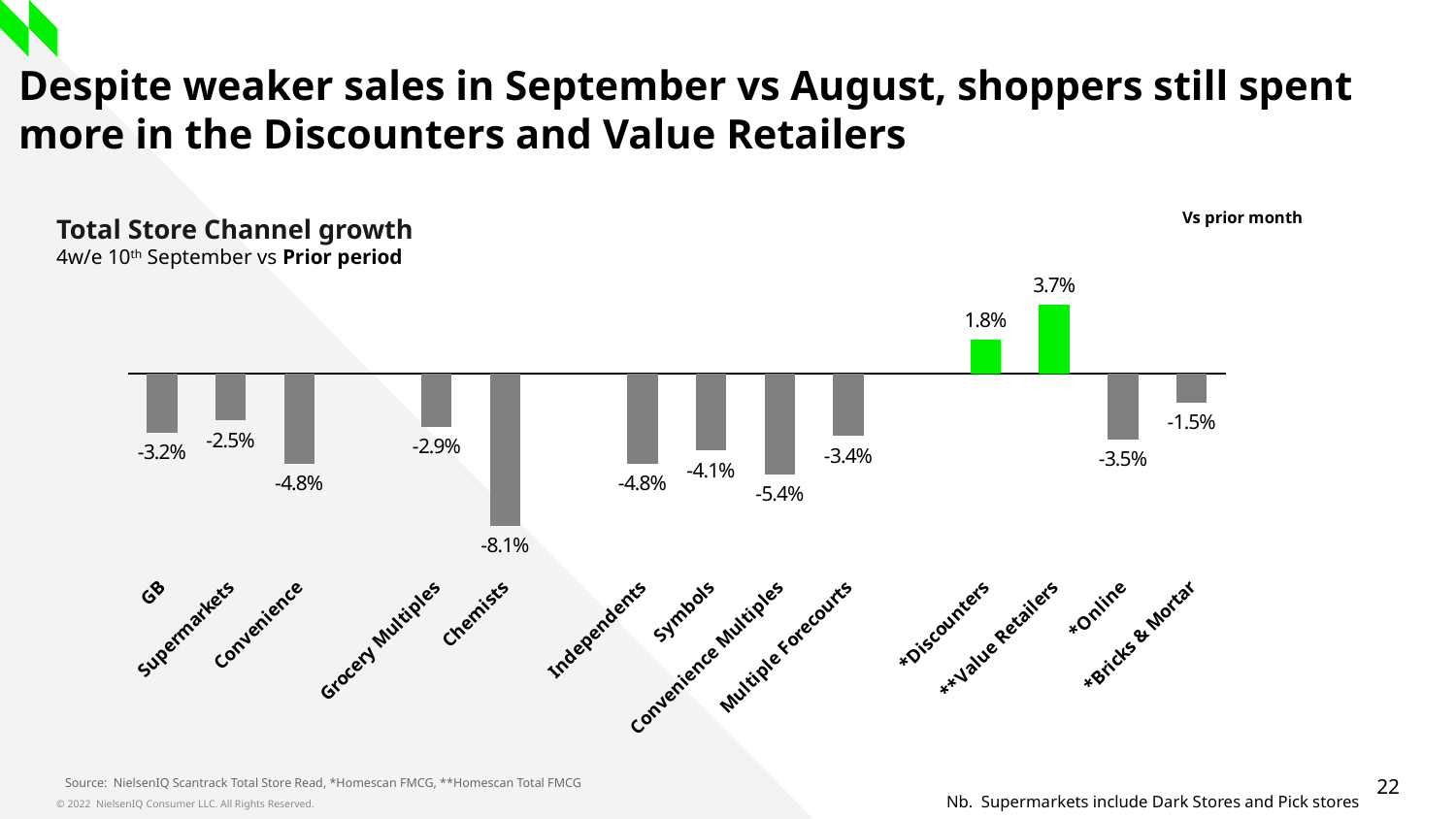
What is the difference between the values for Value Retailers and Discounters? 1.9 percentage points What is the value for Discounters? 1.8% Which channel has the lowest growth? Chemists How many channels are shown on the chart? 13 What is the value for Chemists? -8.1% Which is larger, the value for Supermarkets or the value for Convenience? Supermarkets What is the value for GB? -3.2% What is the value for Value Retailers? 3.7% What is the value for Online? -3.5% What is the title of the chart? Total Store Channel growth What kind of chart is this? Bar chart Which channel has the highest growth? Value Retailers